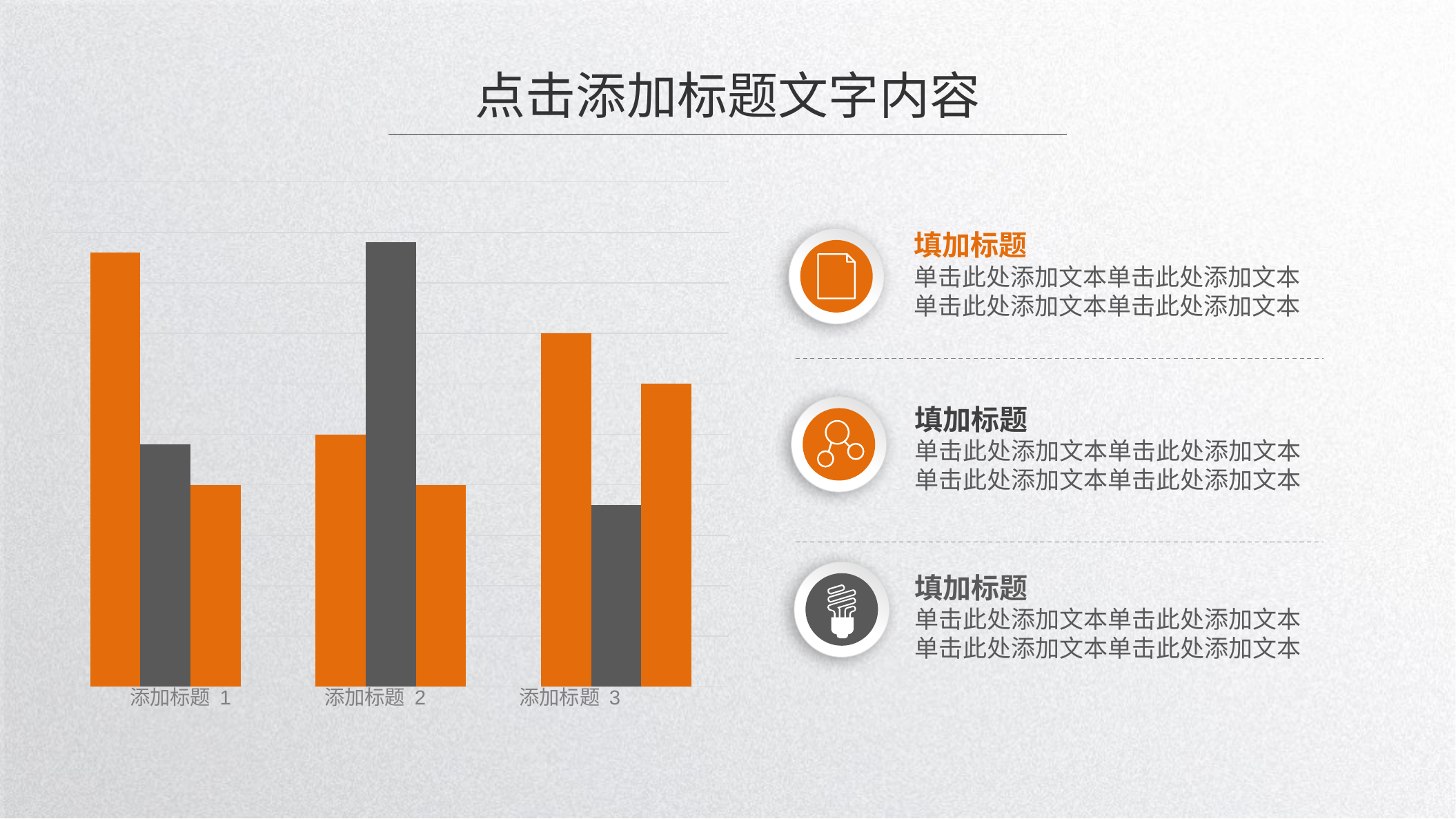
In the bar chart, is the third (right) bar for 添加标题 3 taller or shorter than the third (right) bar for 添加标题 1? taller In the bar chart, is the grey bar for 添加标题 2 taller or shorter than the grey bar for 添加标题 1? taller In the bar chart, is the first (left) bar for 添加标题 1 taller or shorter than the first (left) bar for 添加标题 2? taller What kind of chart is shown on the left of the slide? bar chart In the bar chart, which category contains the tallest bar overall? 添加标题 2 What two colours are used for the bars in the chart? orange and grey In the bar chart, which bar is the tallest within the category 添加标题 1? the first (left) orange bar How many categories are shown along the x axis of the bar chart? 3 In the bar chart, which bar is the shortest within the category 添加标题 3? the middle grey bar How many bars are plotted for each category in the bar chart? 3 What is the title text at the top of the slide? 点击添加标题文字内容